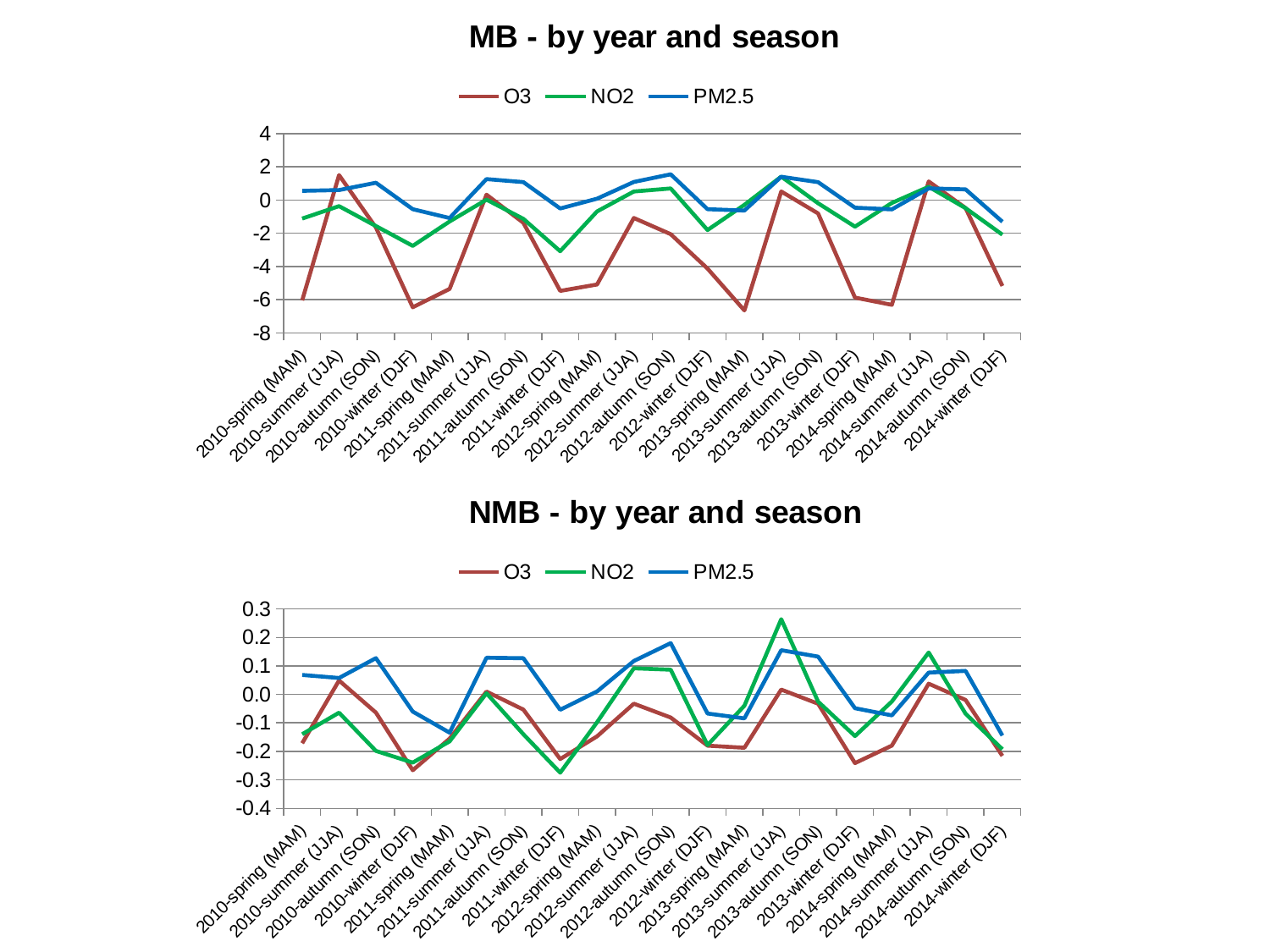
In the 'MB - by year and season' chart, which series has the lowest value at 2010-winter (DJF)? O3 How many series does the legend of the 'NMB - by year and season' chart list? 3 What is the title of the lower chart on the slide? NMB - by year and season How many categories are shown on the x axis of the 'MB - by year and season' chart? 20 In the 'MB - by year and season' chart, is the NO2 value for 2011-winter (DJF) greater or less than -2? less In the 'MB - by year and season' chart, is the O3 value for 2010-winter (DJF) greater or less than -4? less What kind of chart is the 'MB - by year and season' chart? line chart In the 'NMB - by year and season' chart, is the O3 value for 2010-winter (DJF) greater or less than -0.2? less In the 'MB - by year and season' chart, which is larger at 2010-summer (JJA): the O3 value or the NO2 value? O3 In the 'NMB - by year and season' chart, which series has the highest value at 2013-summer (JJA)? NO2